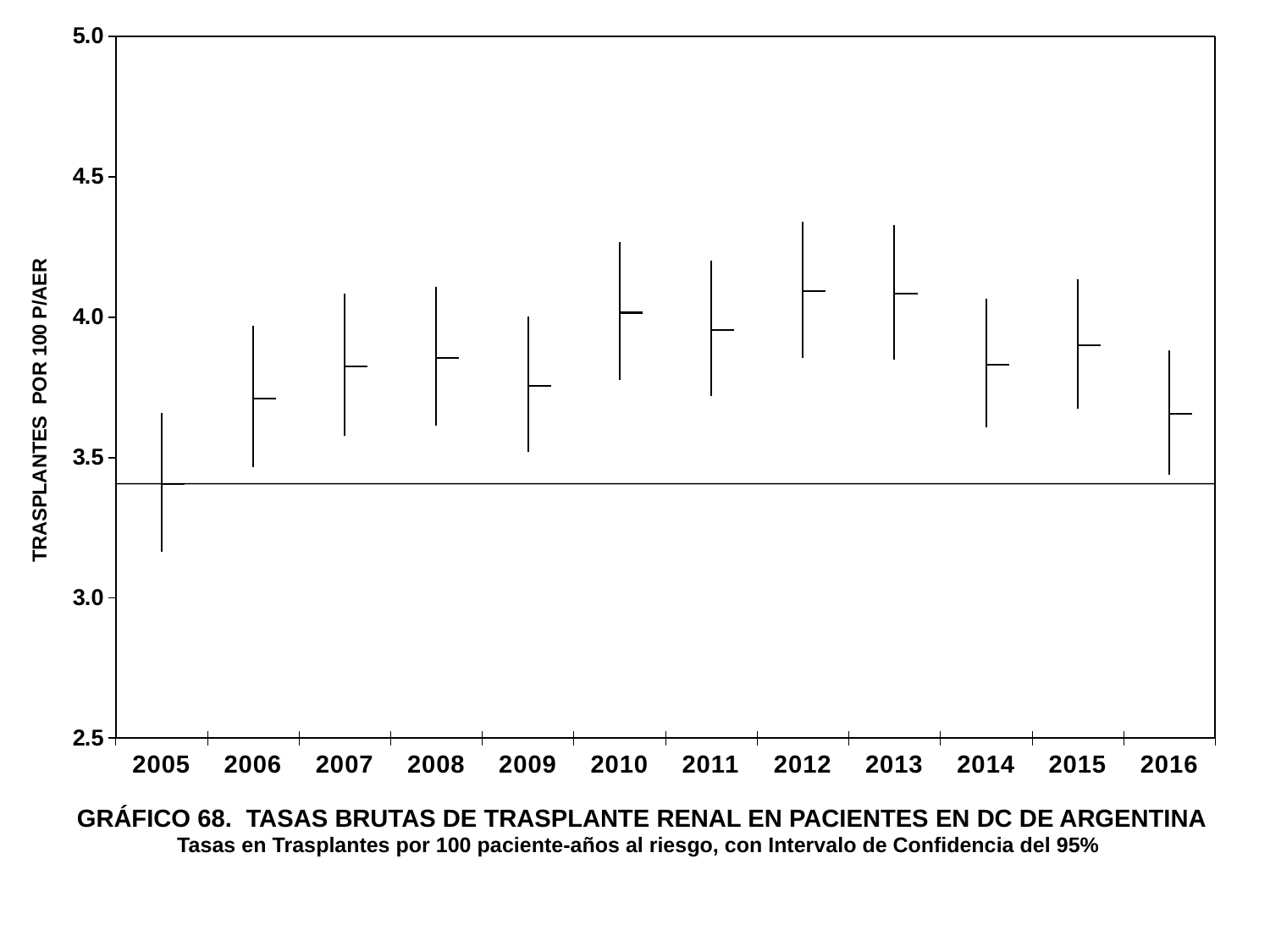
What confidence interval level does the chart subtitle say the bars represent? 95% Which year has the lowest transplant rate in the chart? 2005 What is the label of the y axis of the chart? TRASPLANTES POR 100 P/AER How many years are shown on the x axis of the chart? 12 Which year has the higher transplant rate, 2005 or 2010? 2010 Is the transplant rate for 2005 greater or less than 3.5? less Which year has the higher transplant rate, 2012 or 2016? 2012 Do the transplant rates rise or fall from 2005 to 2008? rise Is the transplant rate for 2006 greater or less than 4.0? less Do the transplant rates rise or fall from 2013 to 2016? fall Is the transplant rate for 2016 greater or less than 4.0? less